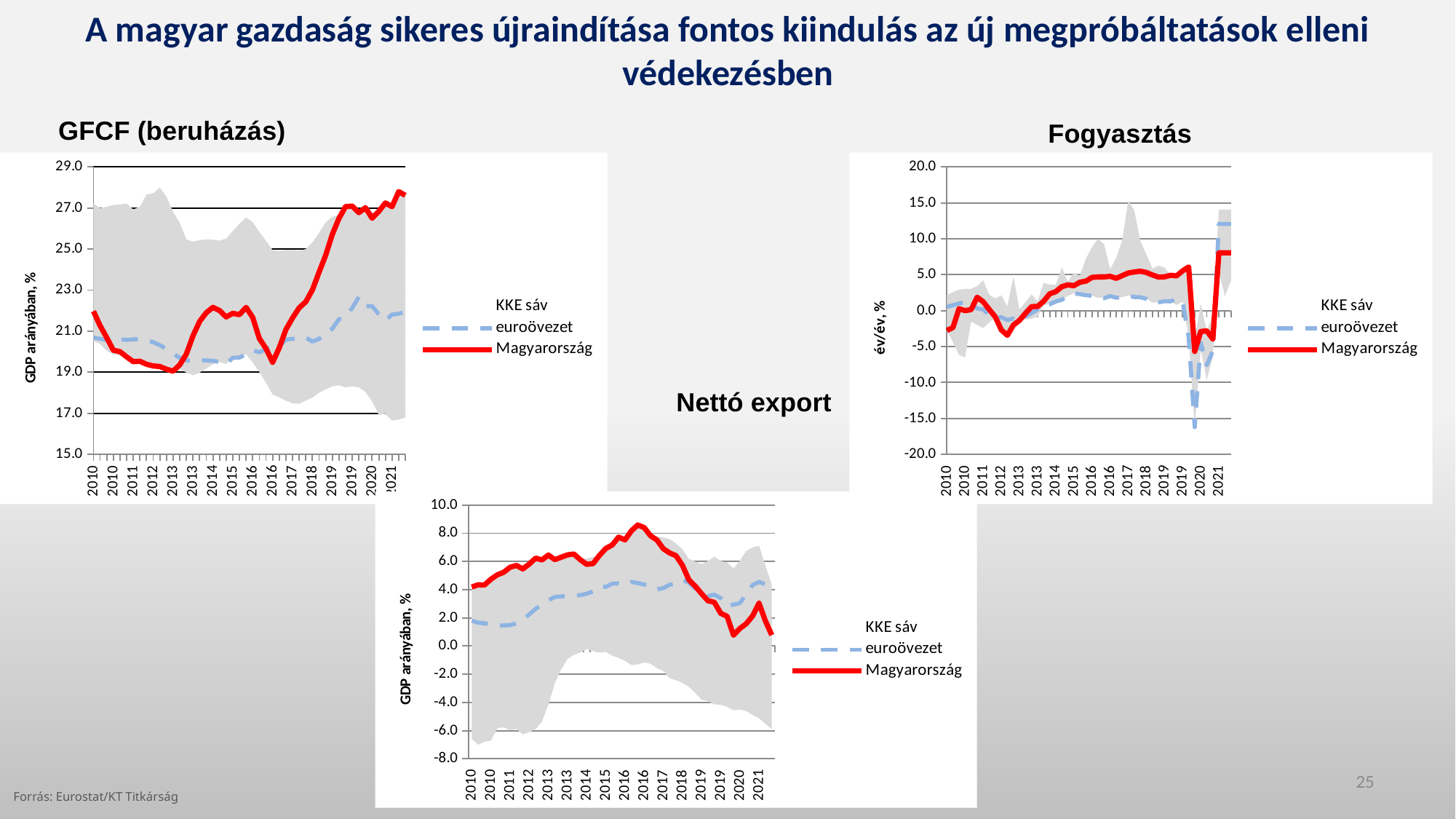
In the GFCF (beruházás) chart, does the Magyarország line rise or fall between 2016 and 2019? rise In the Nettó export chart, does the Magyarország line rise or fall between 2016 and 2021? fall In the Fogyasztás chart, is the lowest value for euroövezet in 2020 greater or less than -10.0? less In the GFCF (beruházás) chart, is the value for Magyarország in 2021 greater or less than 27.0? greater What is the y-axis label of the Fogyasztás chart? év/év, % In the GFCF (beruházás) chart, is the value for euroövezet in 2021 greater or less than 23.0? less How many entries does the legend of the Fogyasztás chart list? 3 What type of chart is the GFCF (beruházás) chart? line chart How many charts are shown on the slide? 3